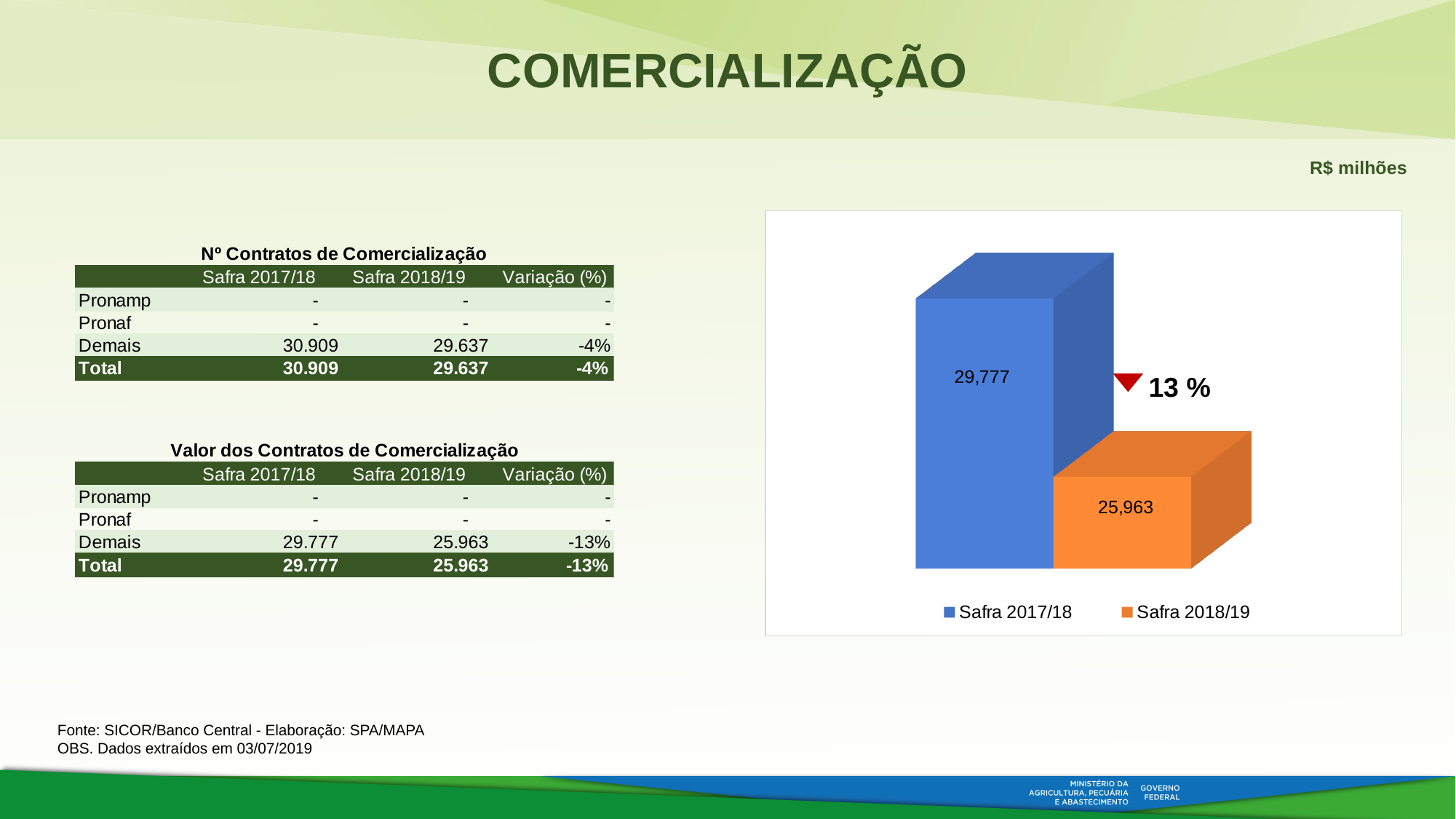
What percentage change is annotated next to the bars in the chart? 13 % How many series does the chart legend list? 2 What is the value of the Safra 2018/19 bar in the chart? 25,963 Which bar in the chart is the highest? Safra 2017/18 Which bar in the chart is the lowest? Safra 2018/19 What is the difference between the Safra 2017/18 and Safra 2018/19 values in the chart? 3,814 Which series has the higher value in the chart, Safra 2017/18 or Safra 2018/19? Safra 2017/18 Do the values in the chart rise or fall from Safra 2017/18 to Safra 2018/19? Fall What kind of chart is shown on the slide? Bar chart What colour is the Safra 2018/19 bar in the chart? Orange How many bars are plotted in the chart? 2 What is the value of the Safra 2017/18 bar in the chart? 29,777